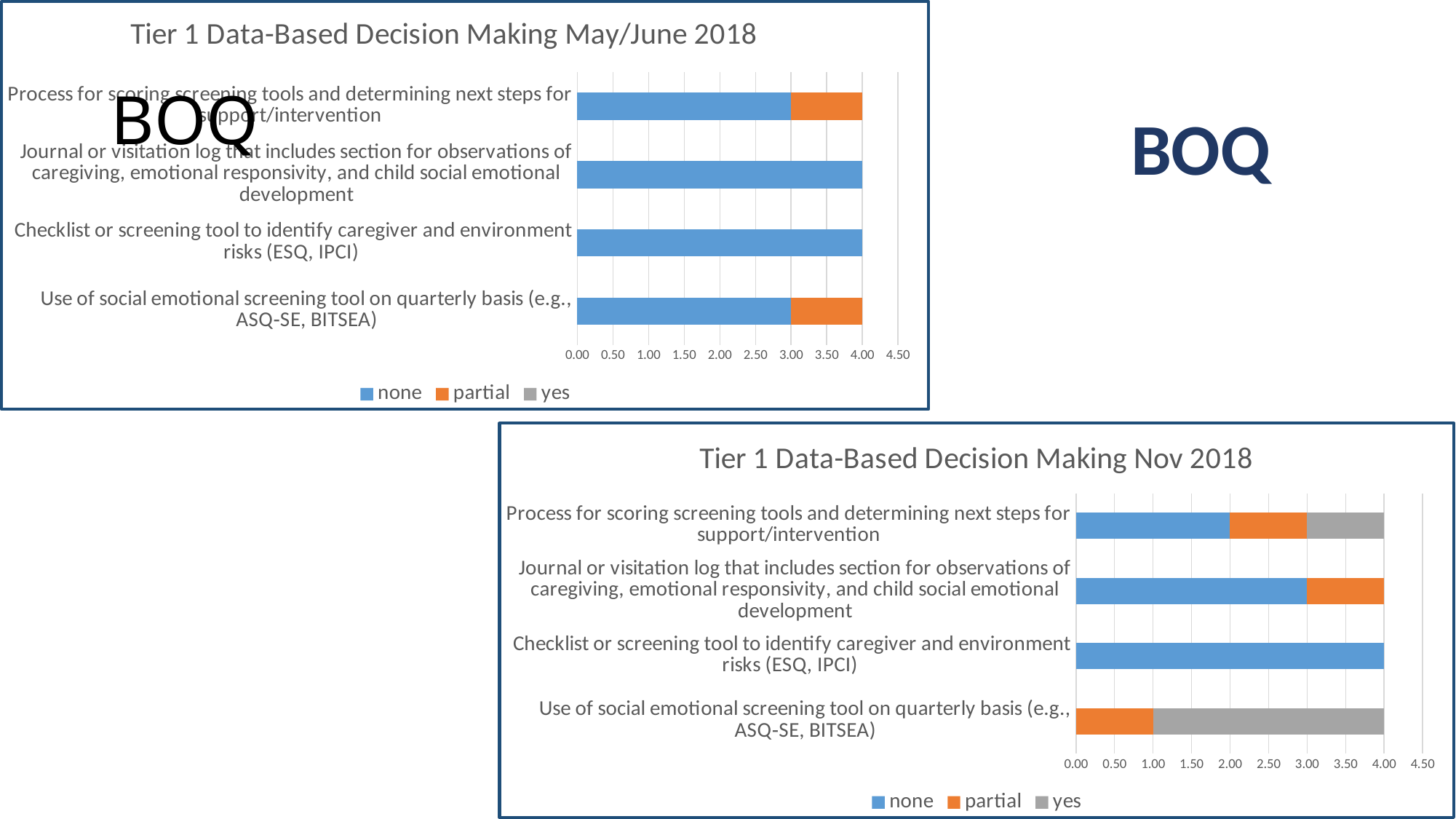
In the 'Tier 1 Data-Based Decision Making Nov 2018' chart, what is the total of the stacked bar for 'Use of social emotional screening tool on quarterly basis (e.g., ASQ-SE, BITSEA)'? 4.00 What are the legend entries of the 'Tier 1 Data-Based Decision Making May/June 2018' chart? none, partial, yes In the 'Tier 1 Data-Based Decision Making Nov 2018' chart, which has the larger 'none' value: 'Checklist or screening tool to identify caregiver and environment risks (ESQ, IPCI)' or 'Process for scoring screening tools and determining next steps for support/intervention'? Checklist or screening tool to identify caregiver and environment risks (ESQ, IPCI) How many categories are shown on the 'Tier 1 Data-Based Decision Making May/June 2018' chart? 4 In the 'Tier 1 Data-Based Decision Making May/June 2018' chart, what is the 'none' value for 'Checklist or screening tool to identify caregiver and environment risks (ESQ, IPCI)'? 4.00 In the 'Tier 1 Data-Based Decision Making Nov 2018' chart, what is the 'none' value for 'Process for scoring screening tools and determining next steps for support/intervention'? 2.00 In the 'Tier 1 Data-Based Decision Making Nov 2018' chart, what is the 'none' value for 'Journal or visitation log that includes section for observations of caregiving, emotional responsivity, and child social emotional development'? 3.00 In the 'Tier 1 Data-Based Decision Making Nov 2018' chart, which category has the largest 'yes' segment? Use of social emotional screening tool on quarterly basis (e.g., ASQ-SE, BITSEA) In the 'Tier 1 Data-Based Decision Making May/June 2018' chart, what is the 'none' value for 'Use of social emotional screening tool on quarterly basis (e.g., ASQ-SE, BITSEA)'? 3.00 How many series does the legend of the 'Tier 1 Data-Based Decision Making Nov 2018' chart list? 3 What kind of chart is the 'Tier 1 Data-Based Decision Making May/June 2018' chart? bar chart In the 'Tier 1 Data-Based Decision Making Nov 2018' chart, is the 'none' value for 'Process for scoring screening tools and determining next steps for support/intervention' greater or less than 3.00? less